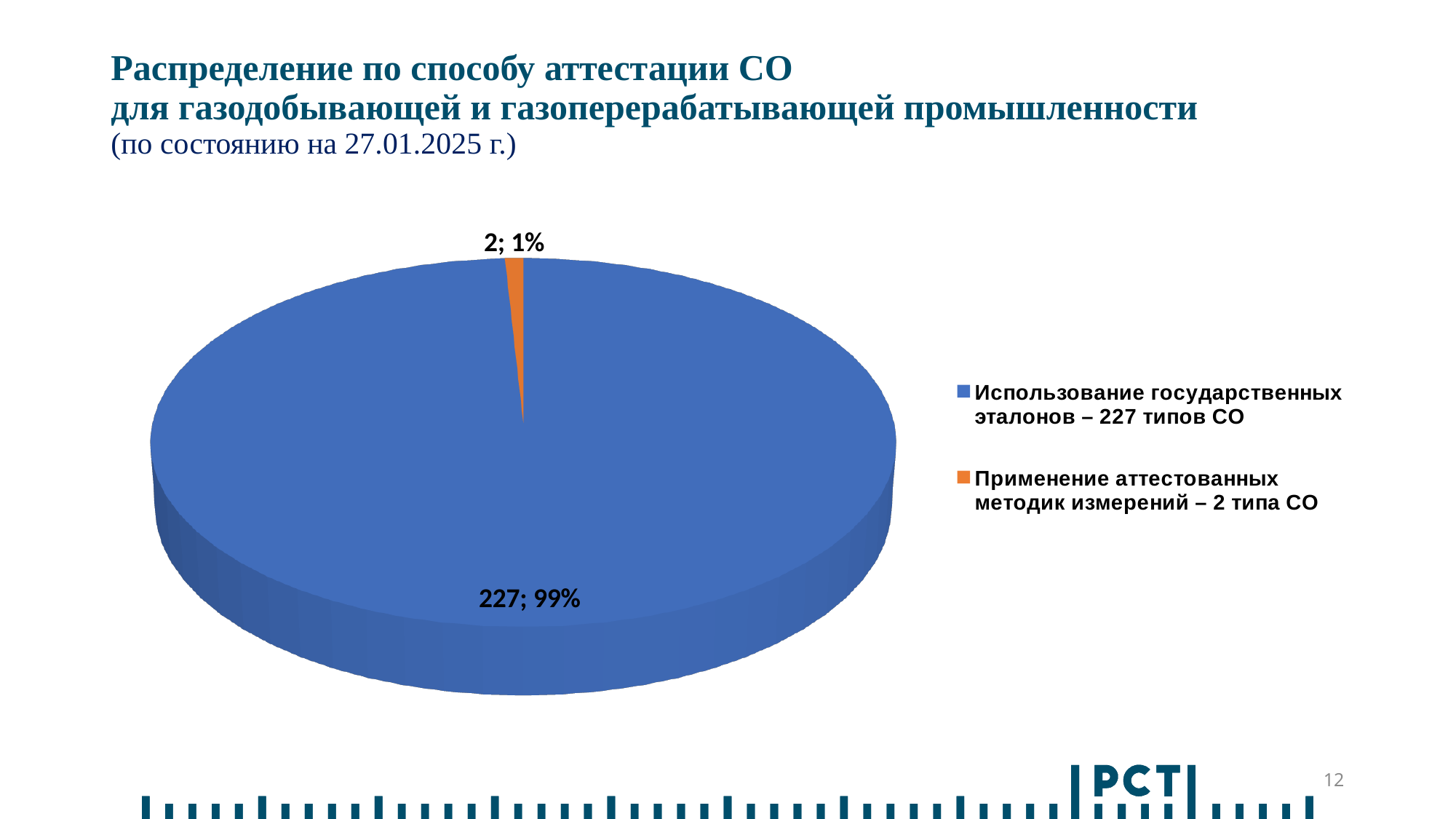
What share of the pie does "Применение аттестованных методик измерений" represent? 1% What kind of chart is shown on the slide? pie chart What is the value for "Использование государственных эталонов"? 227 What colour is the slice for "Применение аттестованных методик измерений"? orange What is the total of the two slice values? 229 What is the value for "Применение аттестованных методик измерений"? 2 What is the difference between the values for "Использование государственных эталонов" and "Применение аттестованных методик измерений"? 225 How many entries does the legend list? 2 How many slices does the pie chart have? 2 Which category has the largest slice? Использование государственных эталонов Which category has the smallest slice? Применение аттестованных методик измерений What share of the pie does "Использование государственных эталонов" represent? 99%